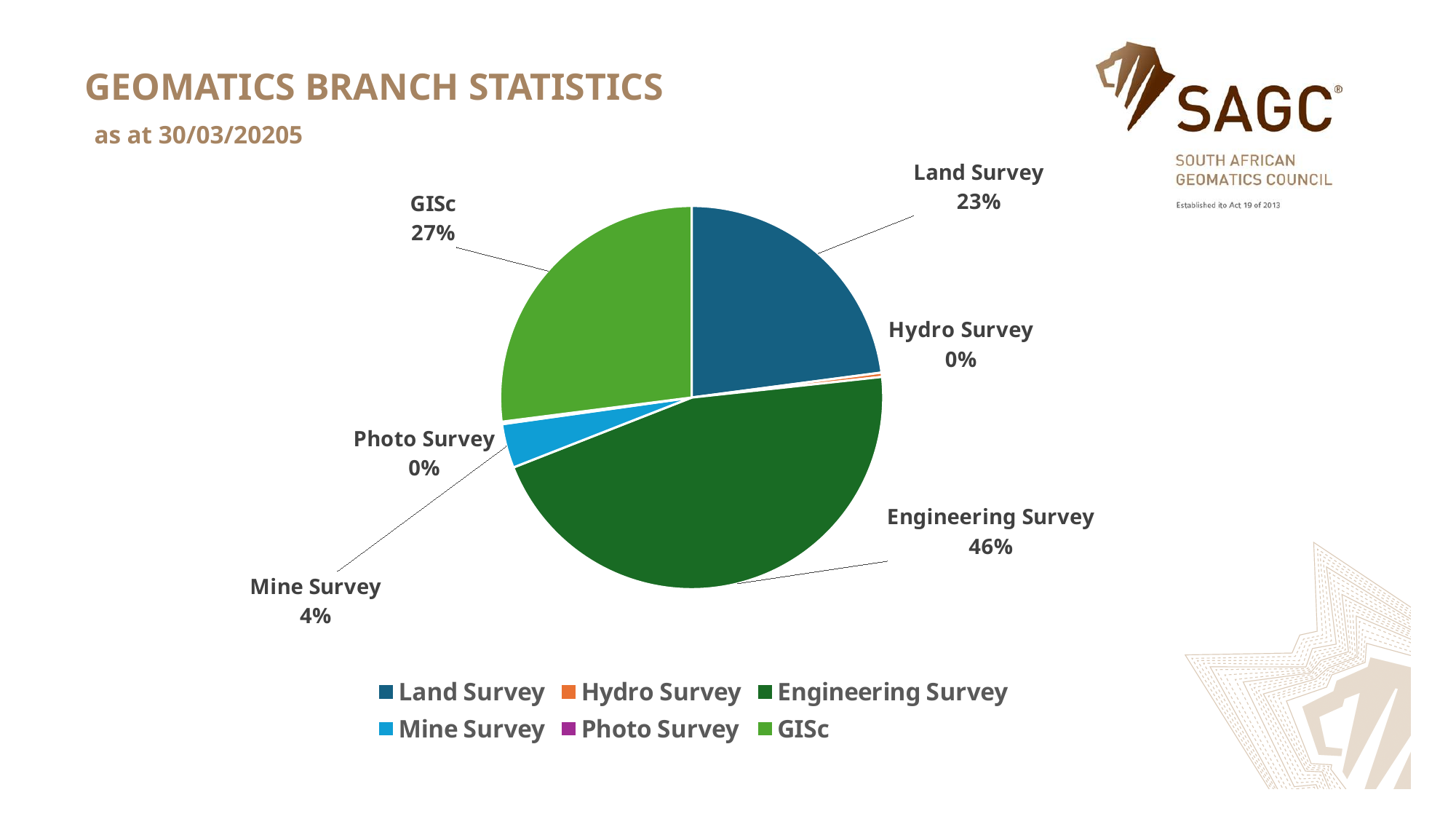
How many branches are listed in the legend? 6 What percentage is shown for GISc? 27% What percentage is shown for Hydro Survey? 0% Which branch has the largest share of the pie? Engineering Survey What percentage is shown for Land Survey? 23% What share of the pie does Engineering Survey hold? 46% What kind of chart is shown on the slide? Pie chart What is the title of the slide containing the chart? GEOMATICS BRANCH STATISTICS Which is larger, the share for GISc or the share for Land Survey? GISc What is the difference in percentage points between Engineering Survey and GISc? 19 What is the difference in percentage points between Land Survey and Mine Survey? 19 What percentage is shown for Mine Survey? 4%